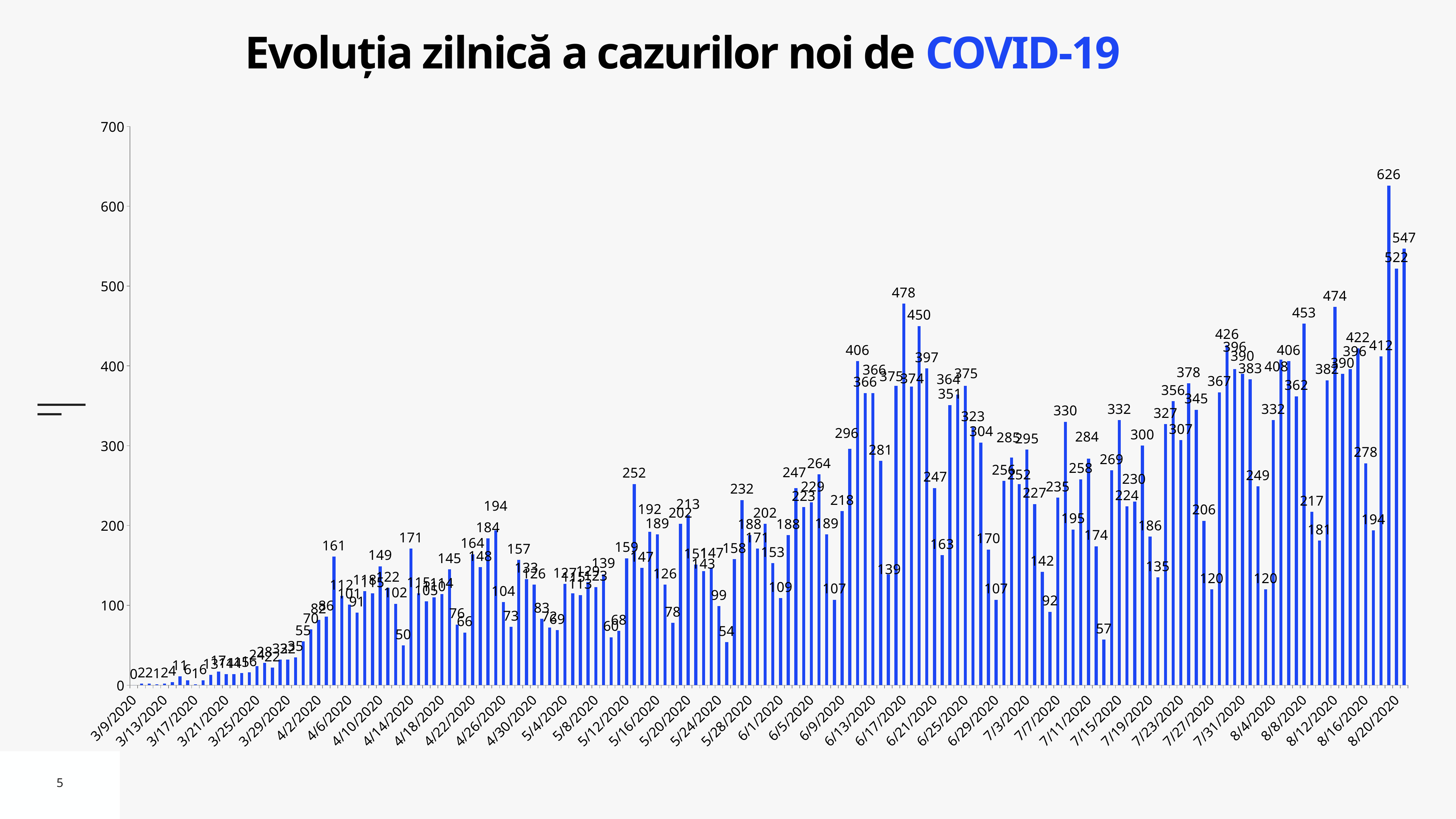
What is the value for 3/9/2020? 0 What kind of chart is shown on the slide? bar chart What is the difference between the highest value (626) and the second highest value (547)? 79 What is the highest daily value shown in the chart? 626 Is the highest value in the chart greater or less than 600? greater Overall, do the daily values rise or fall from March to August 2020? rise What is the title of the chart? Evoluția zilnică a cazurilor noi de COVID-19 What colour are the bars in the chart? blue Is the value for 8/20/2020 greater or less than 300? greater How many bars exceed 500? 3 What is the lowest daily value shown in the chart? 0 Is the value for 3/13/2020 greater or less than 100? less